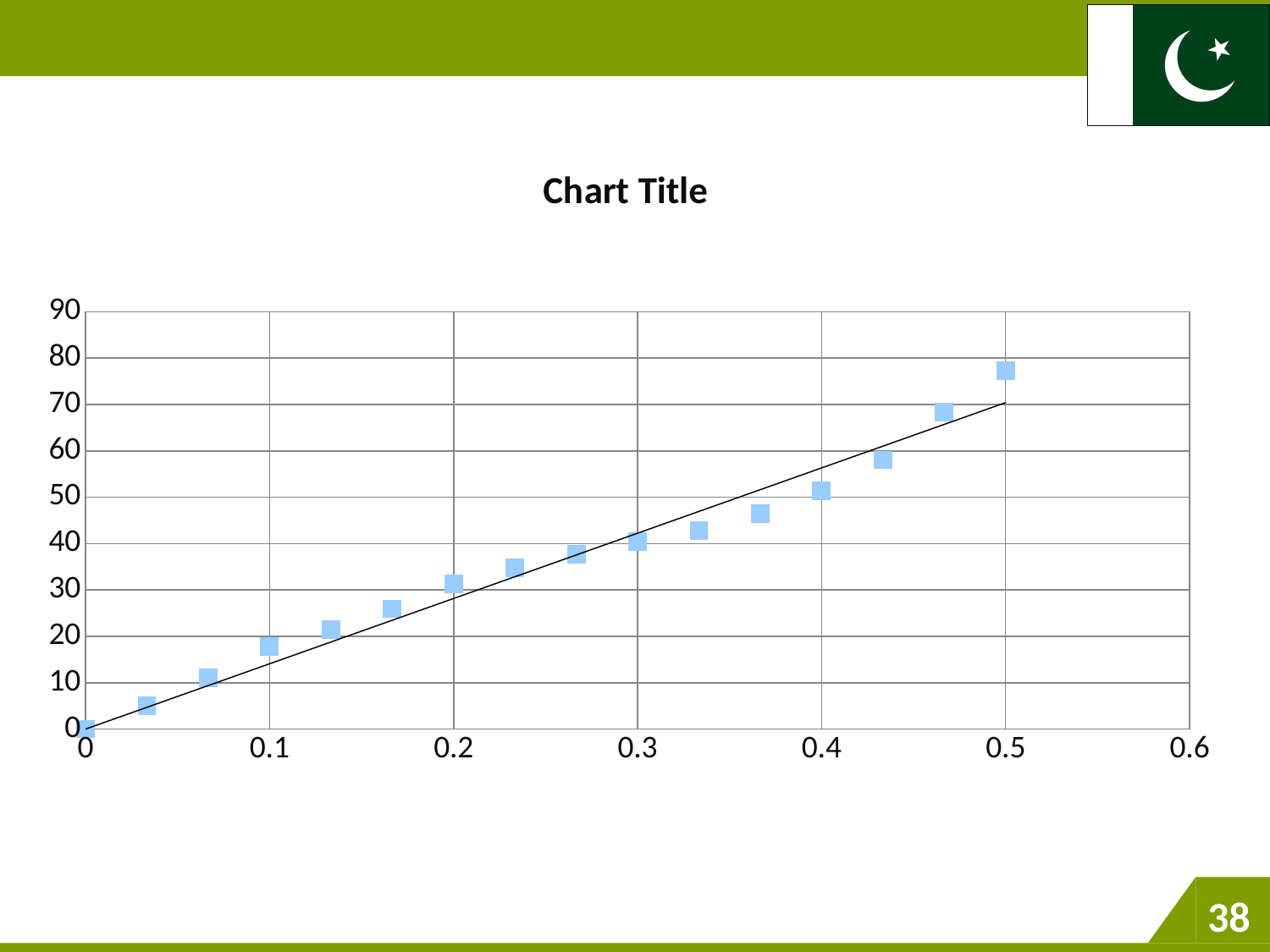
Is the value of the point at x = 0.1 greater or less than 20? less At which x value is the lowest plotted point? 0 Which point has the larger value: the one at x = 0.3 or the one at x = 0.4? x = 0.4 Is the value of the point at x = 0.2 greater or less than 40? less Is the value of the point at x = 0.4 greater or less than 60? less At which x value is the highest plotted point? 0.5 What kind of chart is shown on the slide? scatter chart How many data points are plotted on the chart? 16 What is the title of the chart? Chart Title Do the plotted values rise or fall as x increases along the x axis? rise What is the highest value shown on the y axis? 90